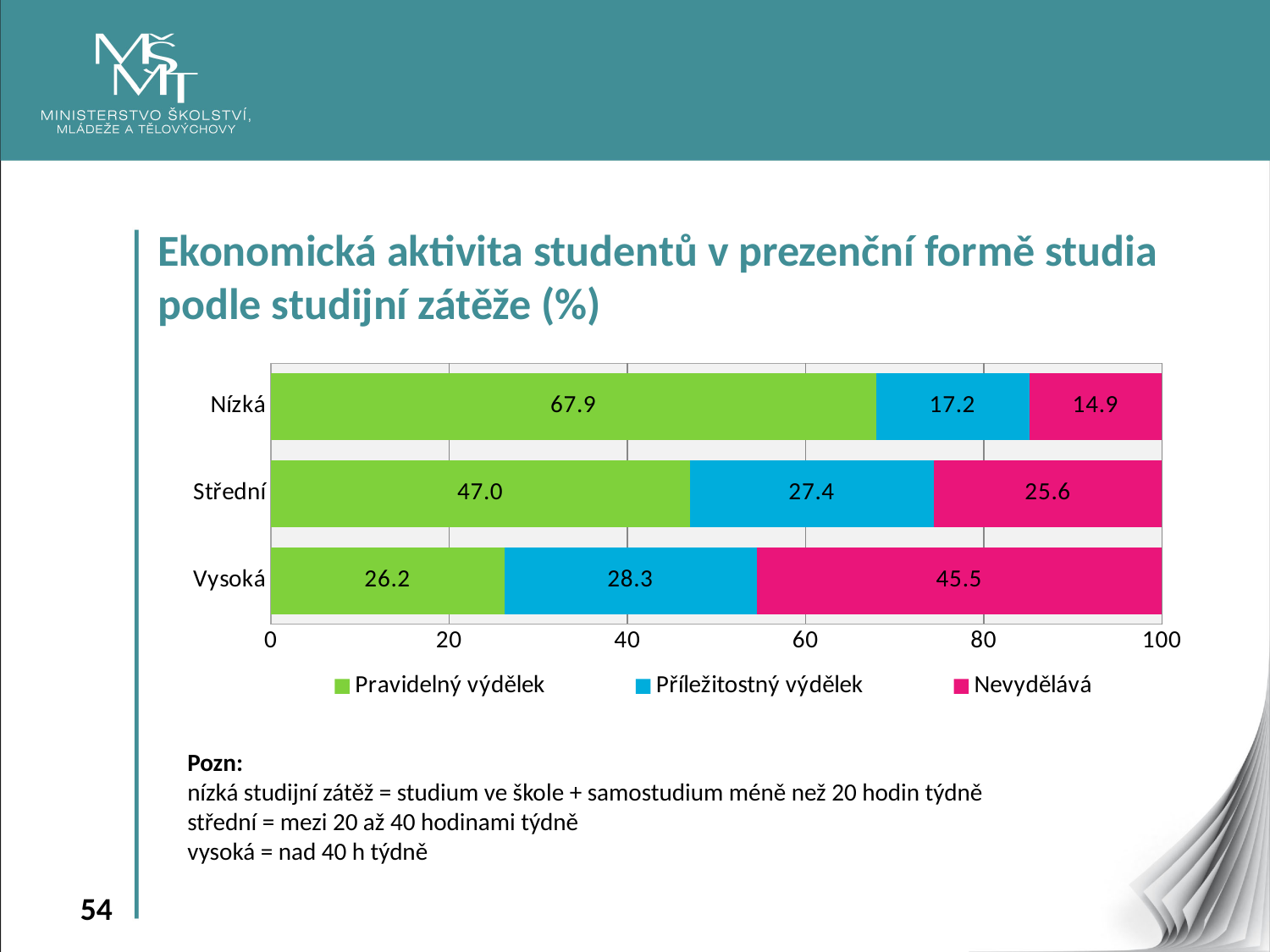
What is the value of Pravidelný výdělek for the Nízká category? 67.9 How many categories are shown on the chart? 3 How many series does the legend list? 3 Which category has the lowest value for Nevydělává? Nízká What is the total of the stacked bar for Střední? 100.0 Which is larger: Příležitostný výdělek for Vysoká or Příležitostný výdělek for Nízká? Vysoká Which category has the highest value for Pravidelný výdělek? Nízká What is the difference between the Pravidelný výdělek values for Nízká and Vysoká? 41.7 What is the value of Příležitostný výdělek for the Střední category? 27.4 Which colour represents Nevydělává in the chart? Pink What kind of chart is shown on the slide? Stacked bar chart What is the value of Nevydělává for the Vysoká category? 45.5